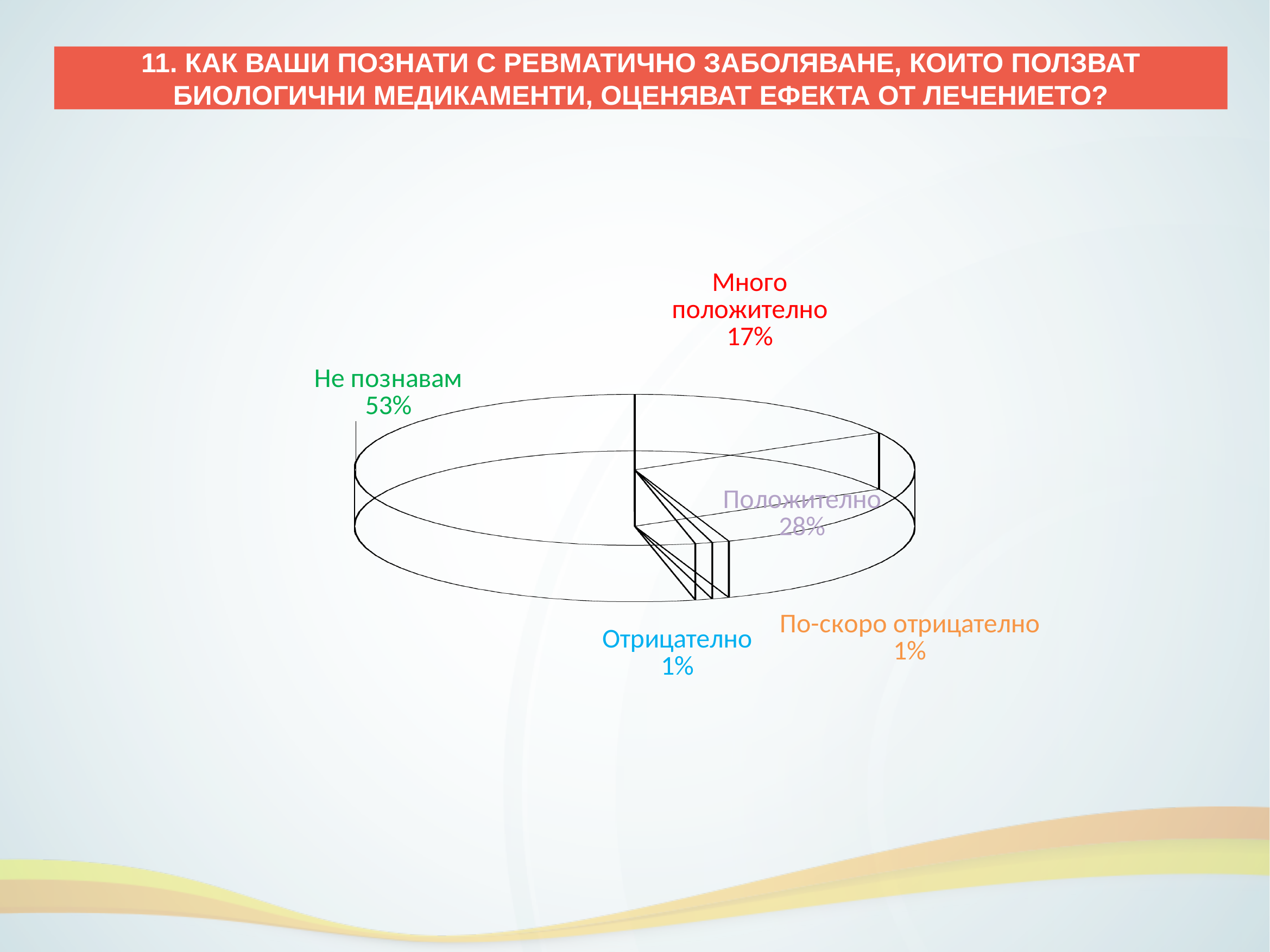
What percentage is shown for "Не познавам"? 53% How many slices does the pie chart have? 5 What percentage is shown for "Отрицателно"? 1% What is the difference between the shares for "Не познавам" and "Положително"? 25 percentage points In what colour is the label "Не познавам" written? green What percentage is shown for "Много положително"? 17% What percentage is shown for "По-скоро отрицателно"? 1% What percentage is shown for "Положително"? 28% Which is larger, the share for "Положително" or the share for "Много положително"? Положително Which category has the largest share of the pie? Не познавам What kind of chart is shown on the slide? pie chart What is the combined share of "Много положително" and "Положително"? 45%